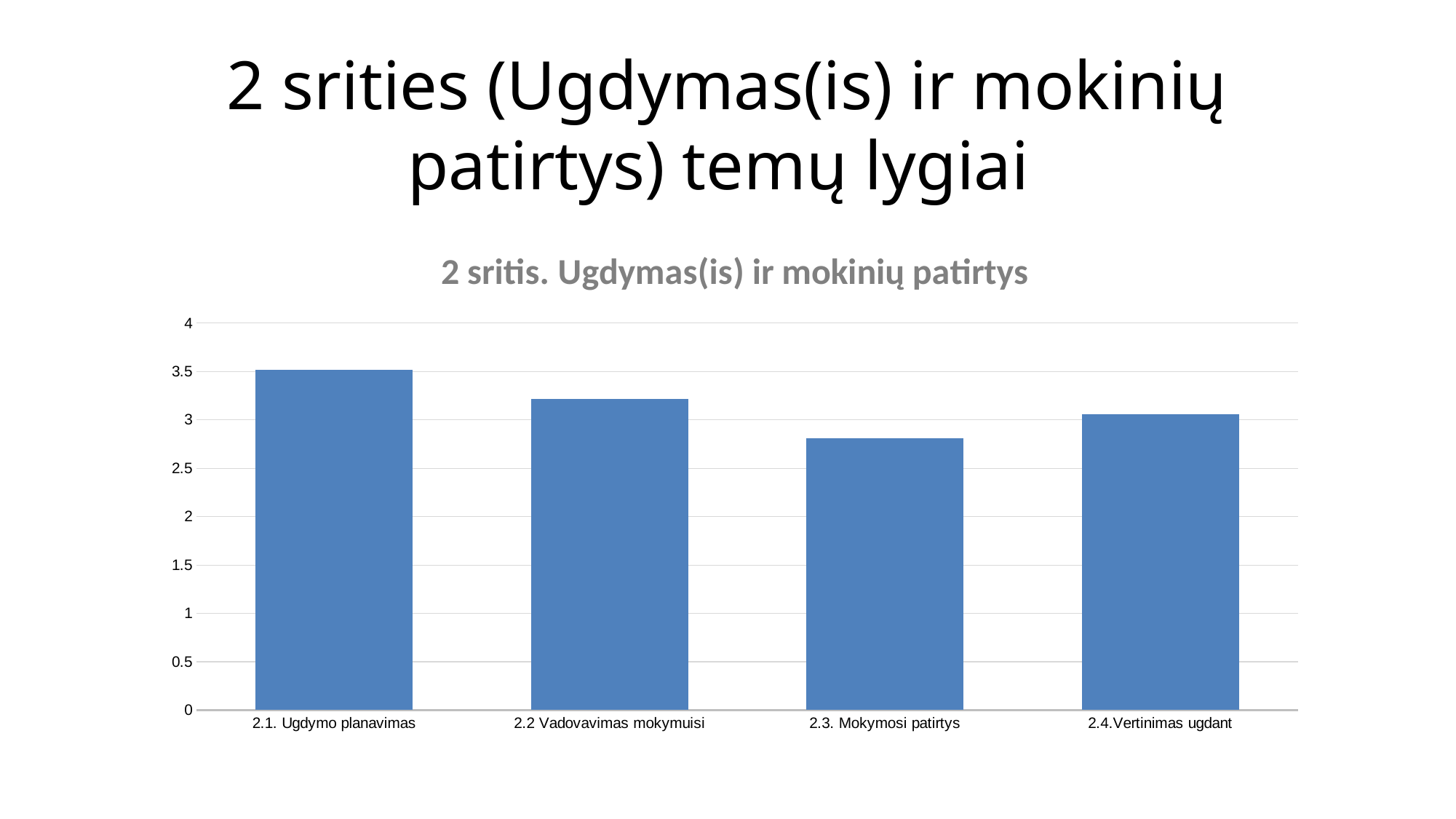
Is the value for 2.4.Vertinimas ugdant greater or less than 2.5? greater Is the value for 2.2 Vadovavimas mokymuisi greater or less than 3.5? less Is the value for 2.1. Ugdymo planavimas greater or less than 3? greater Which category has the highest value? 2.1. Ugdymo planavimas How many categories are shown on the x axis of the chart? 4 What kind of chart is shown on the slide? Bar chart Which is larger, the value for 2.1. Ugdymo planavimas or the value for 2.3. Mokymosi patirtys? 2.1. Ugdymo planavimas Which category has the lowest value? 2.3. Mokymosi patirtys Do the values rise or fall from 2.1. Ugdymo planavimas to 2.3. Mokymosi patirtys? fall What is the title of the chart? 2 sritis. Ugdymas(is) ir mokinių patirtys Which is larger, the value for 2.2 Vadovavimas mokymuisi or the value for 2.4.Vertinimas ugdant? 2.2 Vadovavimas mokymuisi